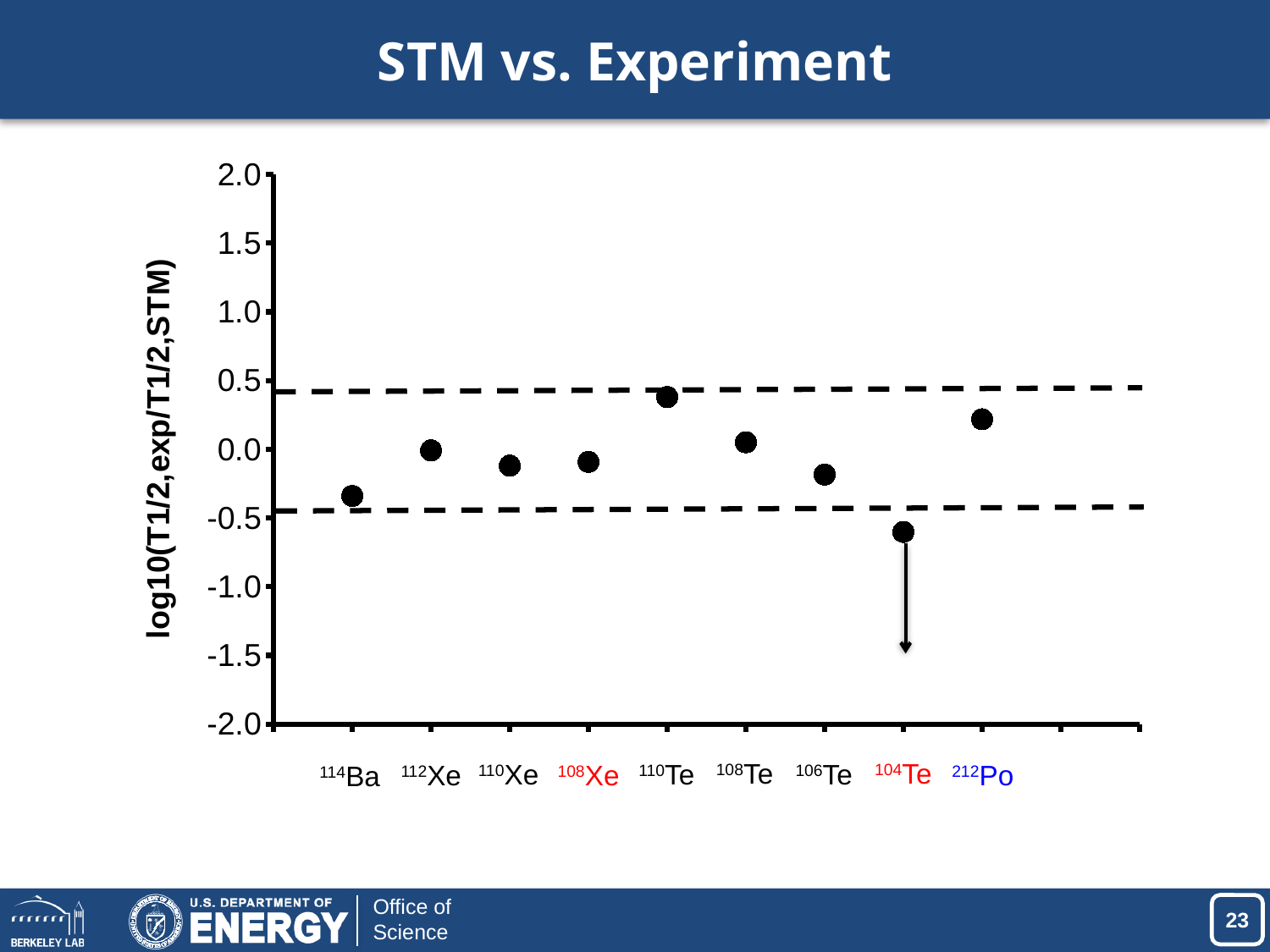
Which isotope's data point has a downward arrow attached to it? 104Te Which isotope has the lowest plotted value? 104Te Is the value for 212Po greater or less than 0.0? greater Is the value for 110Te greater or less than 0.5? less Which has the larger plotted value, 114Ba or 104Te? 114Ba Is the value for 104Te greater or less than -0.5? less What kind of chart is shown on the slide? scatter plot What is the title of the chart? STM vs. Experiment Which isotope has the highest plotted value? 110Te How many isotopes are plotted along the x axis? 9 Which has the larger plotted value, 110Te or 212Po? 110Te